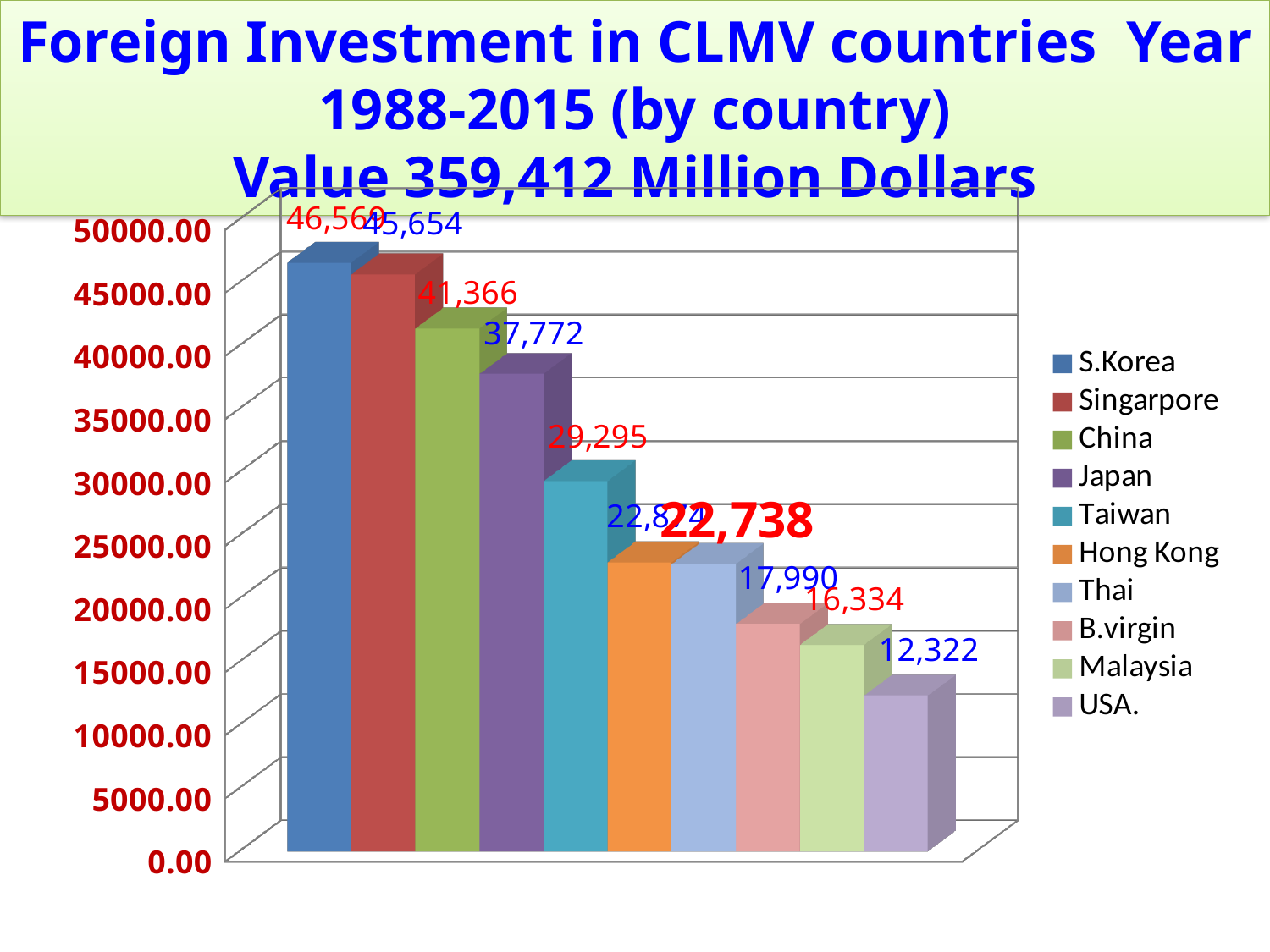
Is the value for Hong Kong greater or less than 25000? less Do the bar values rise or fall from left to right across the chart? Fall What is the value shown for Singapore? 45,654 Which country has the lowest foreign investment value in the chart? USA. Which country has the highest foreign investment value in the chart? S.Korea Which is larger, the value for Japan or the value for Taiwan? Japan What is the value shown for Japan? 37,772 What is the value shown for Taiwan? 29,295 What is the difference between the values for China and Japan? 3,594 What kind of chart is shown on the slide? Bar chart How many countries are plotted in the chart? 10 What is the value shown for Malaysia? 16,334